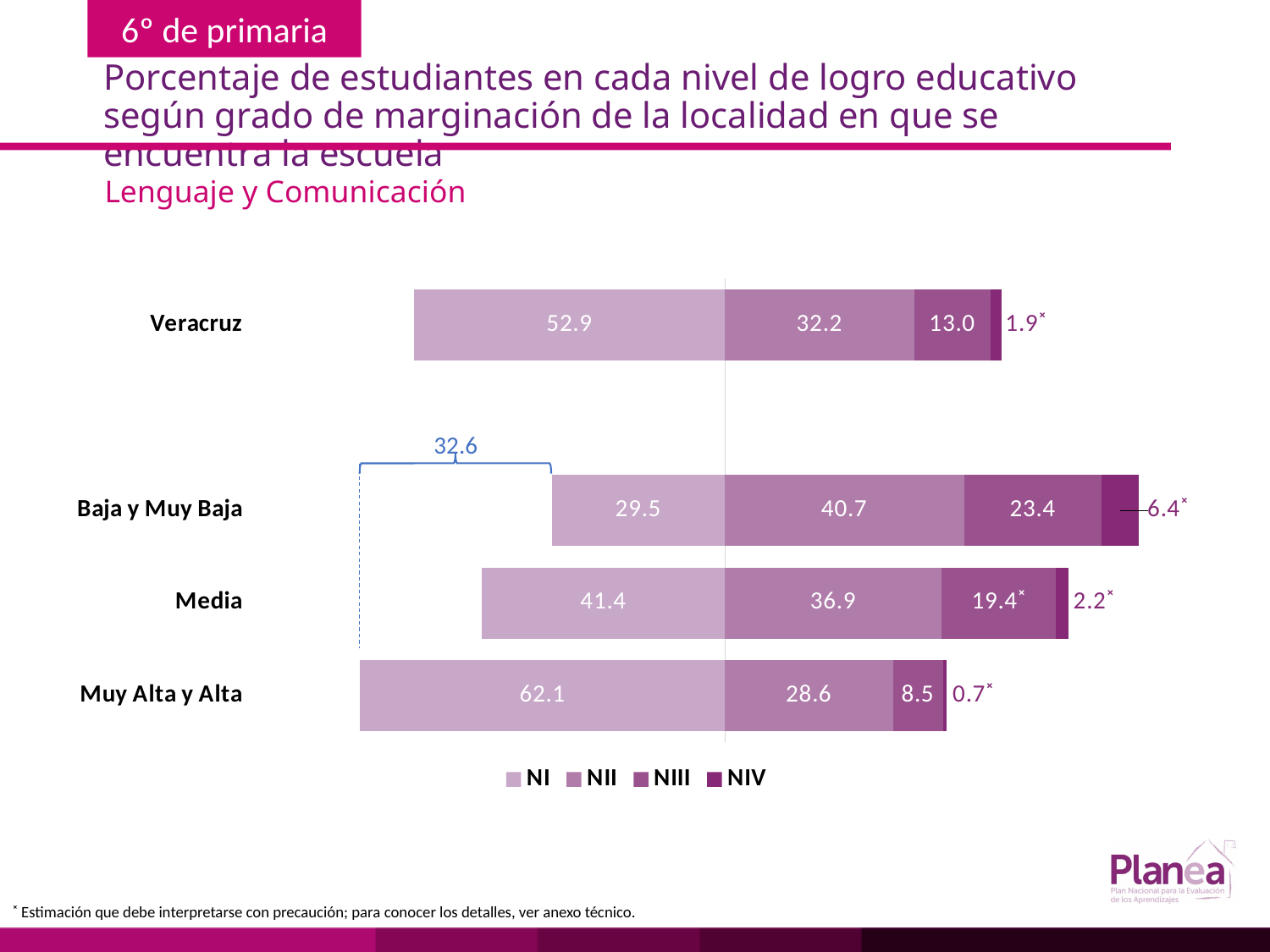
What are the legend entries of the chart? NI, NII, NIII, NIV What is the NIII value for Muy Alta y Alta? 8.5 How many categories are shown on the chart? 4 Which category has the lowest NIII value? Muy Alta y Alta What is the NIV value for Baja y Muy Baja? 6.4 What is the NII value for Media? 36.9 What is the NI value for Veracruz? 52.9 Which category has the highest NI value? Muy Alta y Alta What is the difference between the NI value for Muy Alta y Alta and the NI value for Baja y Muy Baja? 32.6 How many series does the legend list? 4 What kind of chart is shown on the slide? Stacked bar chart Which is larger, the NII value for Media or the NII value for Veracruz? Media